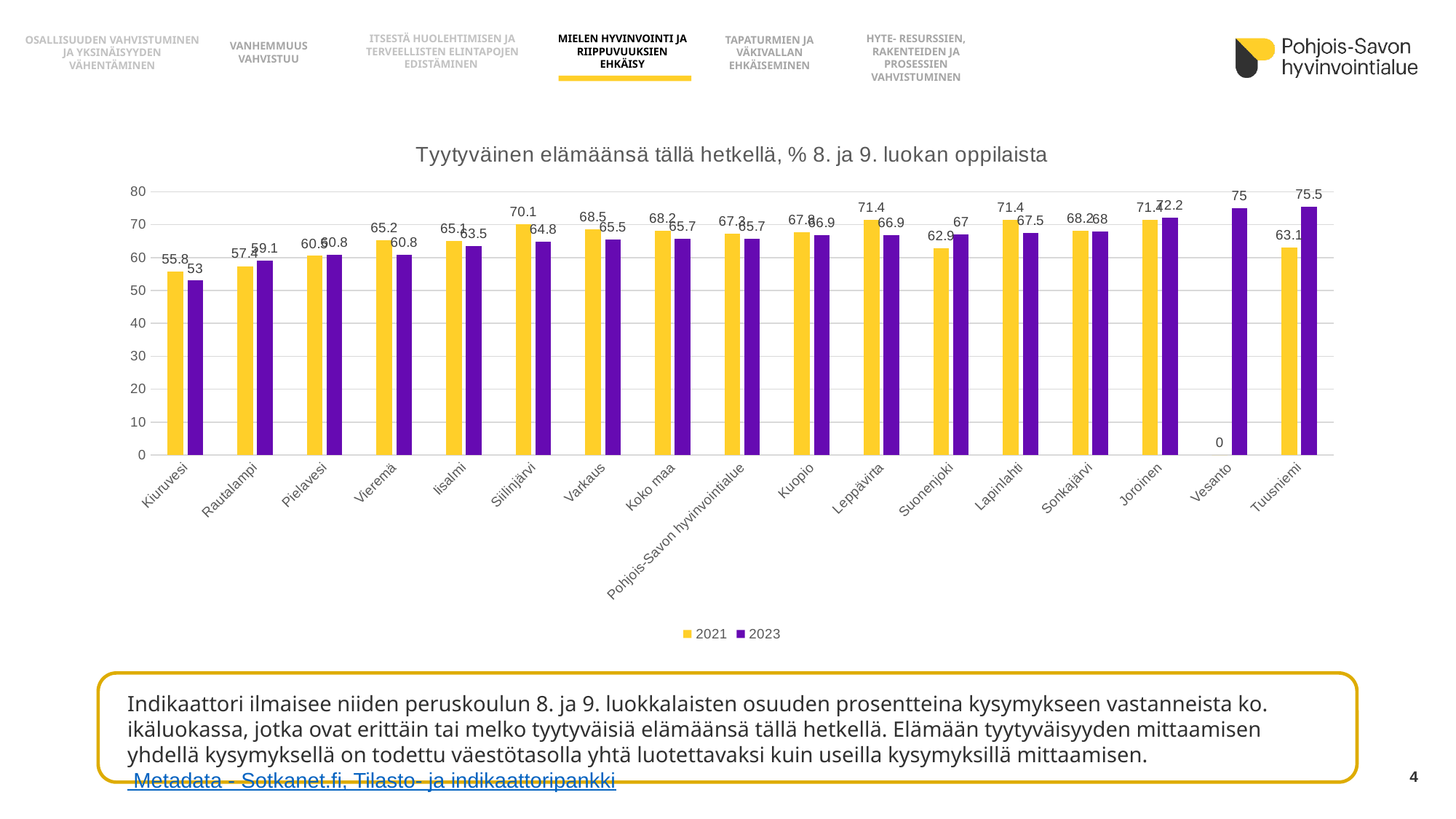
How many categories are shown on the x axis? 17 Is the 2023 value for Vesanto greater or less than 70? greater What is the 2023 value for Tuusniemi? 75.5 What is the 2021 value for Siilinjärvi? 70.1 Which category has the highest 2023 value? Tuusniemi What is the difference between the 2021 and 2023 values for Tuusniemi? 12.4 For Suonenjoki, which is larger: the 2021 value or the 2023 value? 2023 How many series does the legend list? 2 What kind of chart is shown on the slide? bar chart What are the two entries in the chart legend? 2021 and 2023 Which category has the lowest 2023 value? Kiuruvesi What is the 2021 value for Vesanto? 0